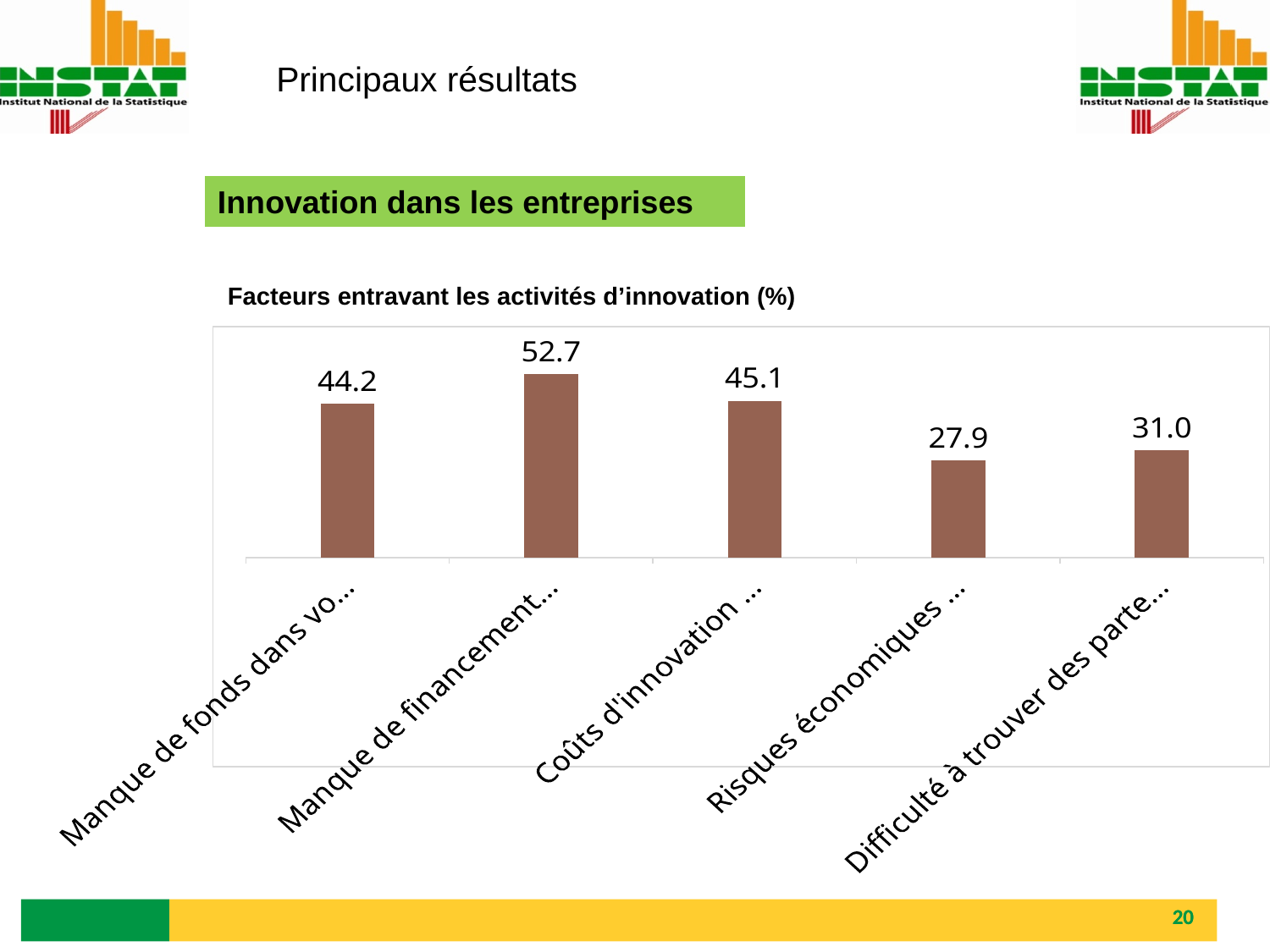
What is the value for the category labelled "Manque de fonds dans vo..."? 44.2 How many categories are shown in the chart? 5 What is the value for the category labelled "Manque de financement..."? 52.7 What is the value for the category labelled "Risques économiques ..."? 27.9 Which is larger, the value for "Difficulté à trouver des parte..." or the value for "Risques économiques ..."? Difficulté à trouver des parte... What is the title of the chart? Facteurs entravant les activités d'innovation (%) What kind of chart is shown on the slide? Bar chart What is the value for the category labelled "Difficulté à trouver des parte..."? 31.0 Which category has the highest value? Manque de financement... What is the difference between the values for "Coûts d'innovation ..." and "Manque de fonds dans vo..."? 0.9 Which category has the lowest value? Risques économiques ... What is the difference between the values for "Manque de financement..." and "Risques économiques ..."? 24.8